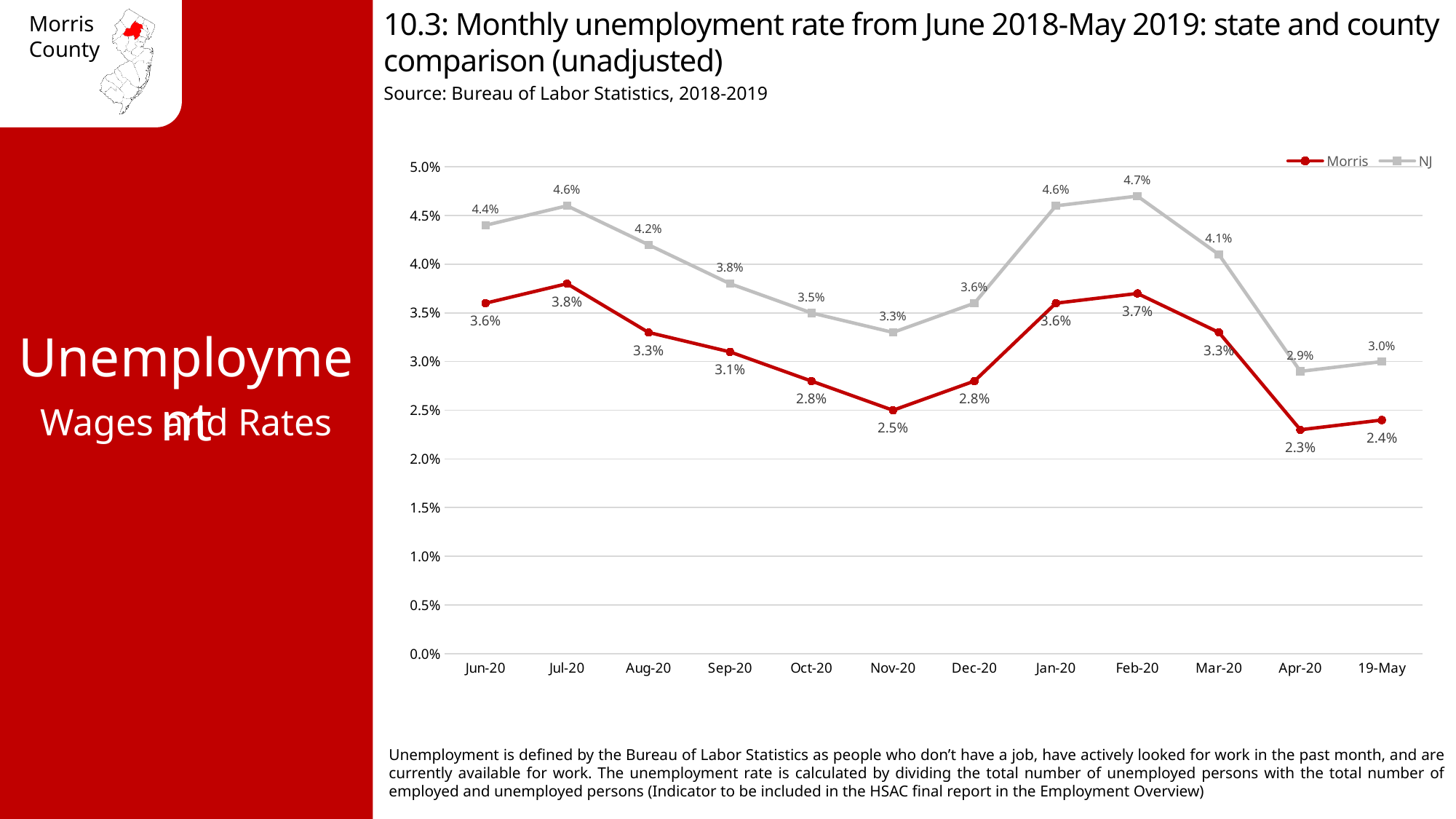
Does the Morris series rise or fall from Jul-20 to Nov-20? Fall How many months are plotted on the x axis? 12 What is the NJ unemployment rate for Feb-20? 4.7% What kind of chart is shown on the slide? Line chart In which month does the Morris series reach its lowest value? Apr-20 What colour is the Morris line in the chart? Red In which month does the NJ series reach its highest value? Feb-20 How many series does the legend list? 2 What is the difference between the NJ and Morris unemployment rates in Jan-20? 1.0% What is the Morris unemployment rate for Nov-20? 2.5% Which series has the higher value in Sep-20, Morris or NJ? NJ What is the Morris unemployment rate for Jul-20? 3.8%